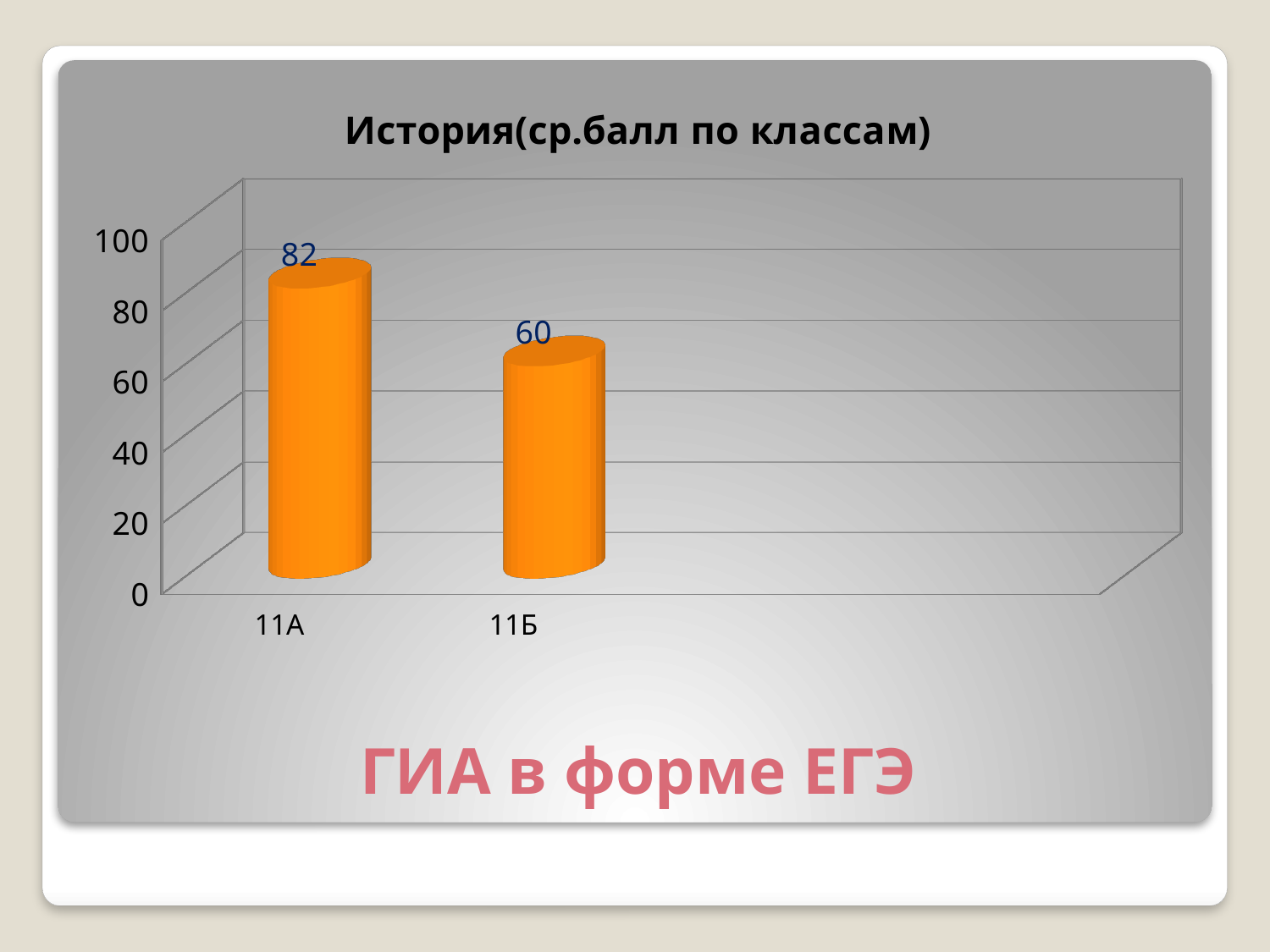
Which class has the highest average score? 11А What is the difference between the values for 11А and 11Б? 22 What is the value for 11Б? 60 What is the title of the chart? История(ср.балл по классам) Which class has the lowest average score? 11Б What colour are the bars on the chart? orange What kind of chart is shown on the slide? bar chart What is the value for 11А? 82 How many classes are shown on the chart? 2 Which is larger, the value for 11А or the value for 11Б? 11А Is the value for 11А greater or less than 60? greater Is the value for 11Б greater or less than 80? less